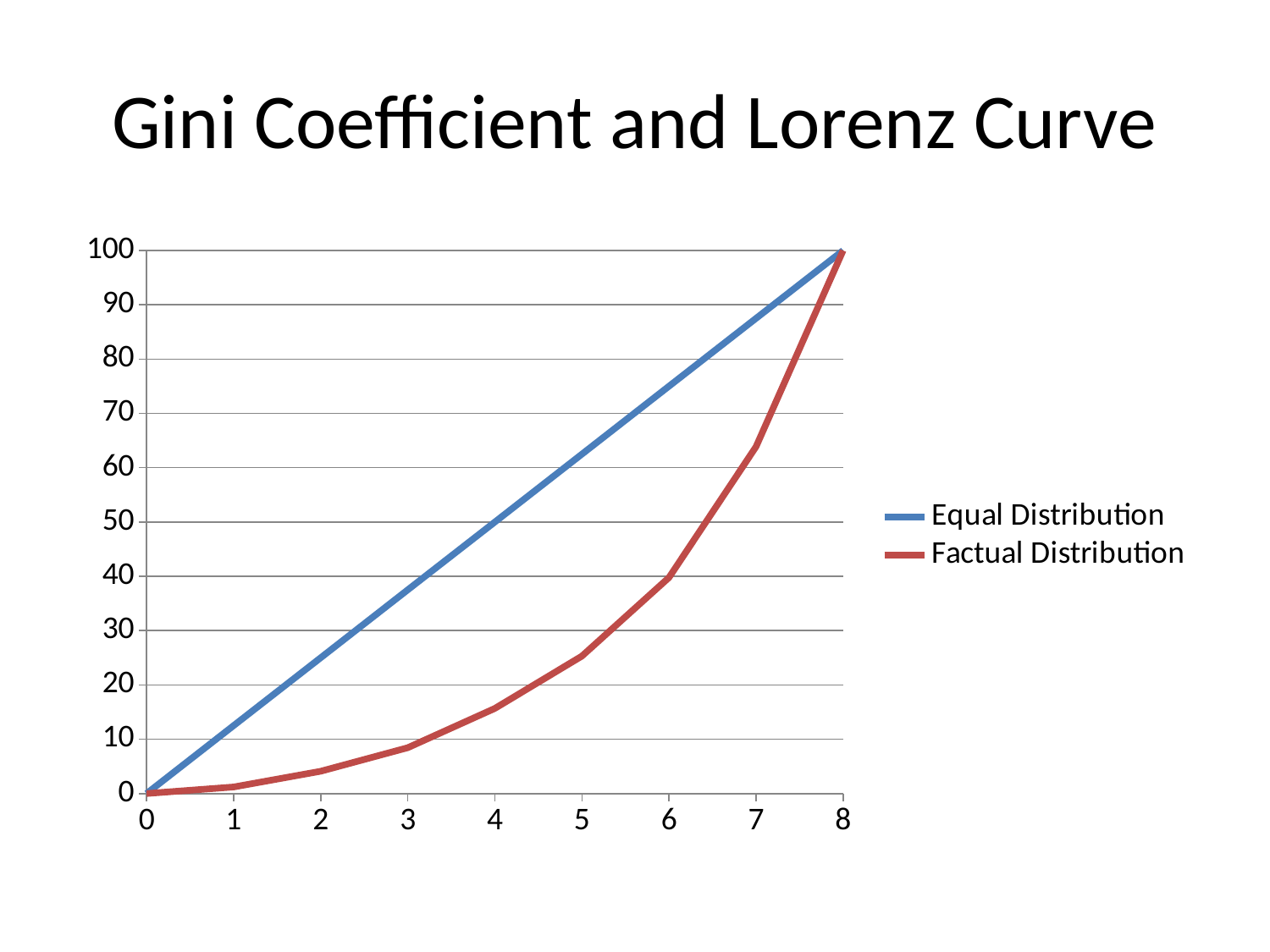
Is the value of the Factual Distribution series at x = 7 greater or less than 60? greater Is the value of the Factual Distribution series at x = 5 greater or less than 30? less What is the title of the slide's chart? Gini Coefficient and Lorenz Curve Do the values of the Factual Distribution series rise or fall as x increases from 0 to 8? rise Is the value of the Factual Distribution series at x = 3 greater or less than 20? less What is the value of the Equal Distribution series at x = 8? 100 What are the two series named in the legend? Equal Distribution and Factual Distribution What is the value of the Factual Distribution series at x = 0? 0 What is the value of the Equal Distribution series at x = 4? 50 What kind of chart is shown on the slide? line chart At x = 4, which series has the higher value, Equal Distribution or Factual Distribution? Equal Distribution How many series does the legend list? 2